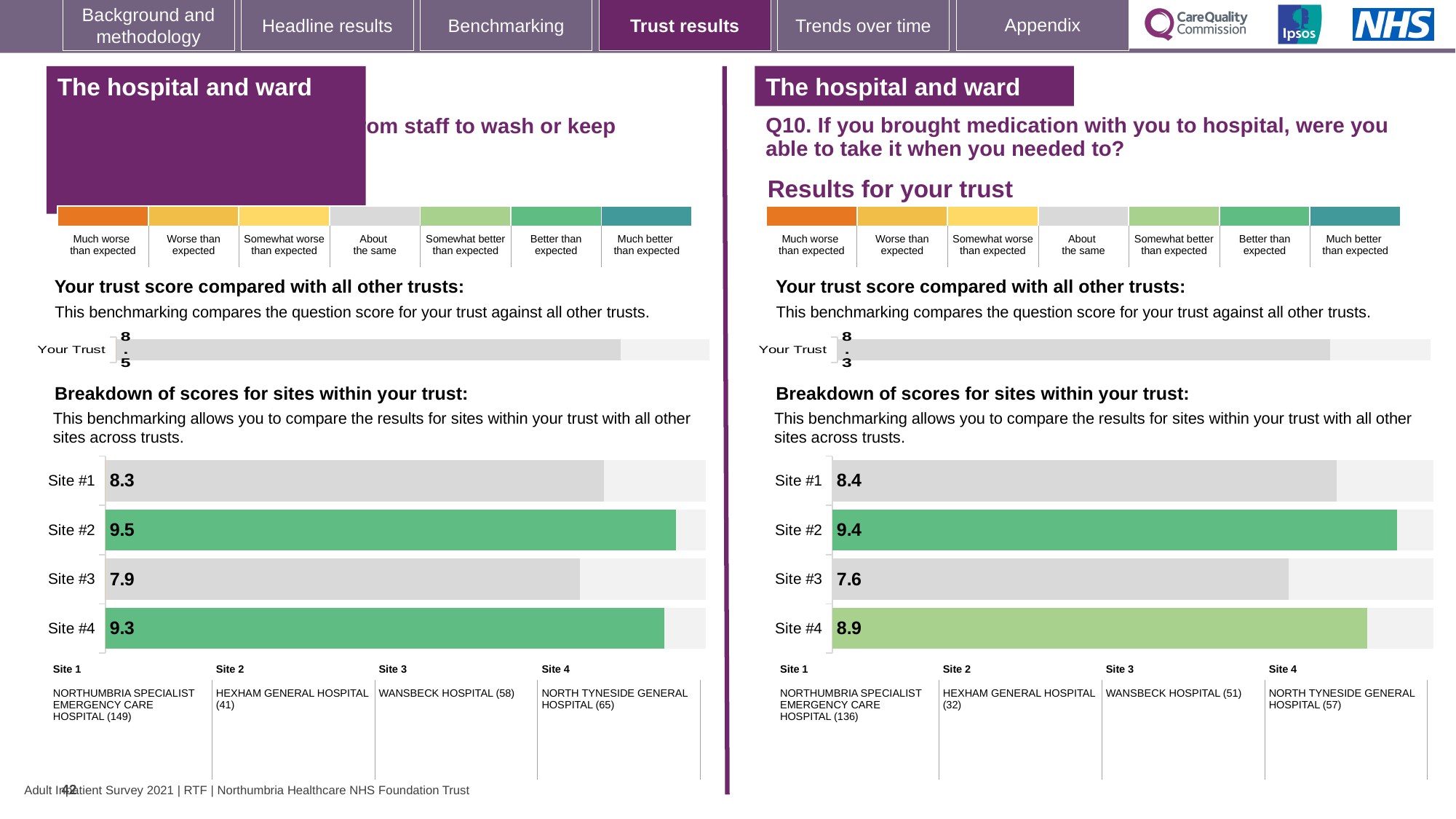
In the site breakdown chart on the right (Q10), which site has the lowest score? Site #3 In the site breakdown chart on the right (Q10), what is the score for Site #2? 9.4 In the site breakdown chart on the left, what is the difference between the scores for Site #2 and Site #1? 1.2 In the site breakdown chart on the right (Q10), what is the score for Site #4? 8.9 What type of chart is used for the breakdown of scores for sites on the left? Bar chart In the 'Your trust score compared with all other trusts' chart on the right (Q10), what is the score for Your Trust? 8.3 How many sites are shown in the site breakdown chart on the right (Q10)? 4 In the site breakdown chart on the left, what is the score for Site #3? 7.9 In the site breakdown chart on the left, which site has the highest score? Site #2 In the 'Your trust score compared with all other trusts' chart on the left, what is the score for Your Trust? 8.5 In the site breakdown chart on the left, which has the higher score, Site #1 or Site #4? Site #4 In the site breakdown chart on the right (Q10), what is the difference between the scores for Site #2 and Site #3? 1.8